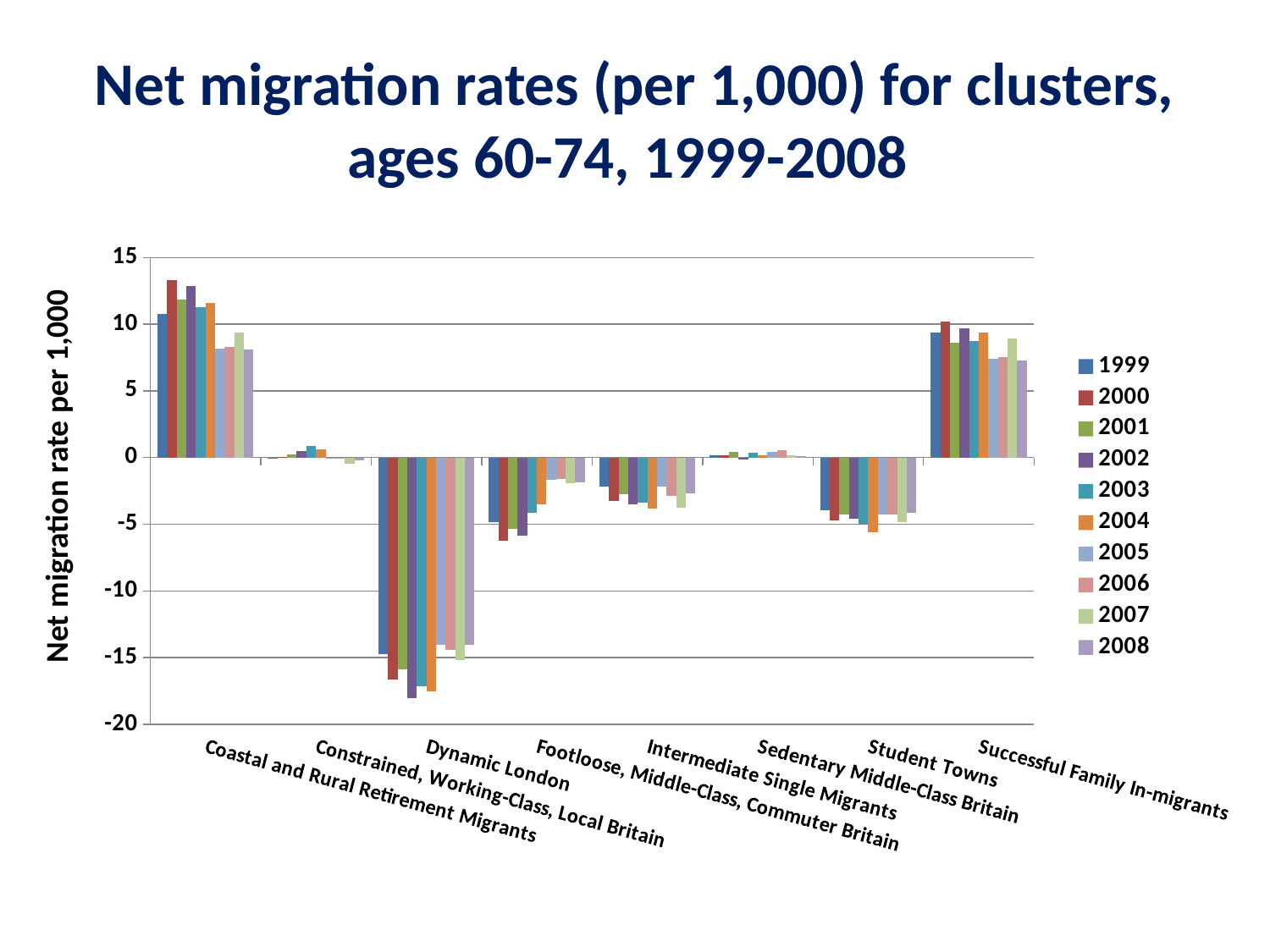
What is the label on the vertical axis? Net migration rate per 1,000 Which is larger, the 2000 value for Coastal and Rural Retirement Migrants or the 2000 value for Successful Family In-migrants? Coastal and Rural Retirement Migrants How many series (years) does the legend list? 10 What kind of chart is shown on the slide? bar chart How many clusters (categories) are shown along the x axis? 8 For Successful Family In-migrants, do the values generally rise or fall from 1999 to 2008? fall Which cluster has the lowest (most negative) net migration rates? Dynamic London Is the 2002 value for Dynamic London greater or less than -15? less Is the 1999 value for Student Towns greater or less than -5? greater Is the 2000 value for Coastal and Rural Retirement Migrants greater or less than 10? greater Which cluster contains the single highest bar on the chart? Coastal and Rural Retirement Migrants